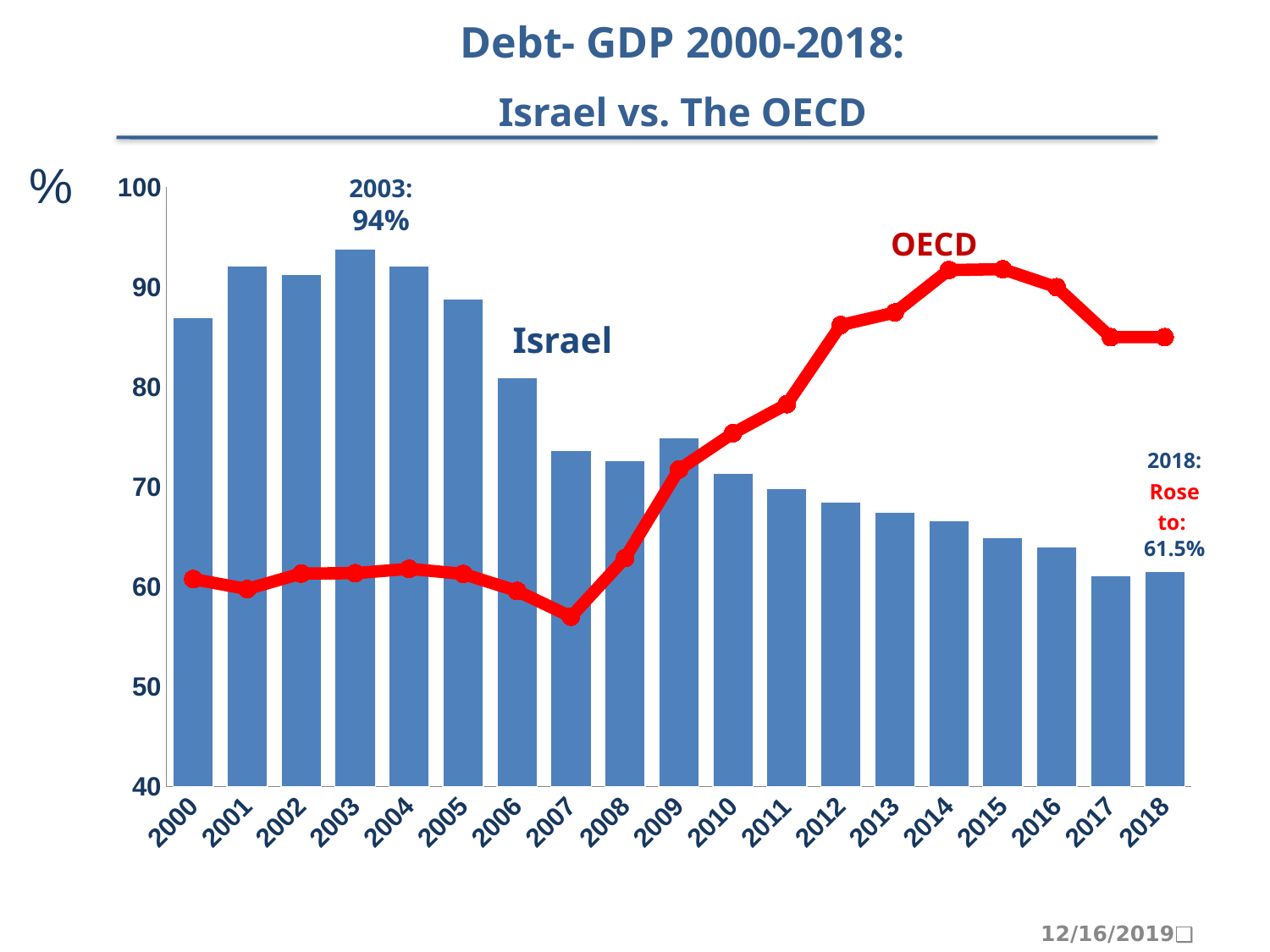
Is the OECD debt-to-GDP value for 2014 greater or less than 90? greater Is Israel's debt-to-GDP value for 2016 greater or less than 70? less Does Israel's debt-to-GDP ratio rise or fall from 2003 to 2017? Fall In 2012, which was higher: Israel's debt-to-GDP ratio or the OECD's? OECD How many years are shown on the x axis? 19 What was Israel's debt-to-GDP ratio in 2003 according to the annotation? 94% What colour is the OECD line? Red What kind of chart is used to show Israel's debt-to-GDP ratio? Bar chart In which year was Israel's debt-to-GDP ratio highest? 2003 What value did Israel's debt-to-GDP ratio rise to in 2018? 61.5% By how many percentage points did Israel's debt-to-GDP ratio fall from 2003 to 2018? 32.5 In which year was the OECD debt-to-GDP ratio lowest? 2007